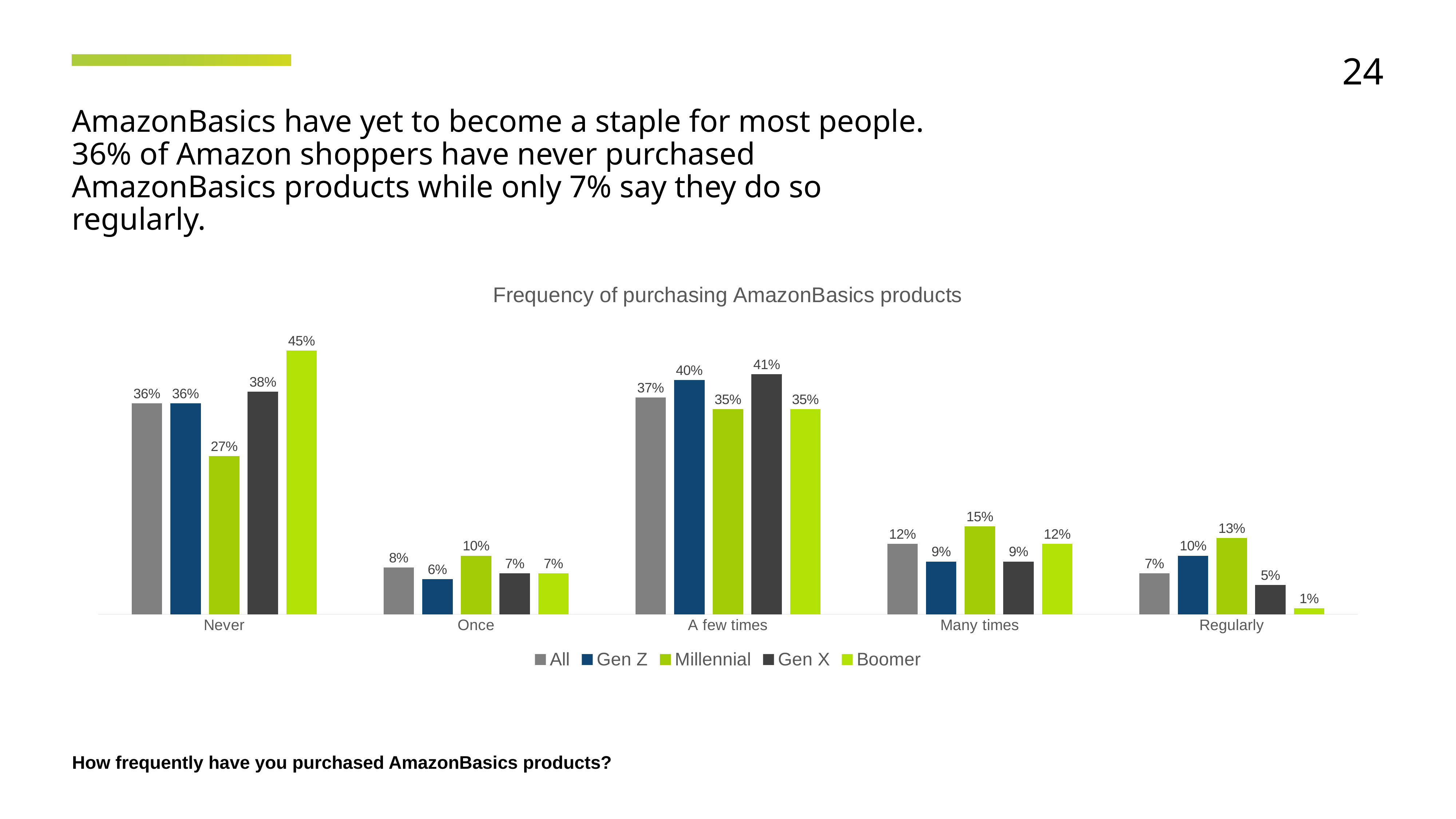
What is the value for Boomer in the Never category? 45% What kind of chart is shown on the slide? Bar chart What is the value for Millennial in the Regularly category? 13% How many categories are shown on the x axis? 5 Which series has the highest value in the Never category? Boomer Which is larger in the Many times category: Millennial or Gen X? Millennial What is the value for Gen Z in the A few times category? 40% What is the difference between the Boomer and Millennial values in the Never category? 18% Which series has the lowest value in the Regularly category? Boomer How many series does the legend list? 5 What is the title of the chart? Frequency of purchasing AmazonBasics products What is the difference between the Gen X values for A few times and Regularly? 36%